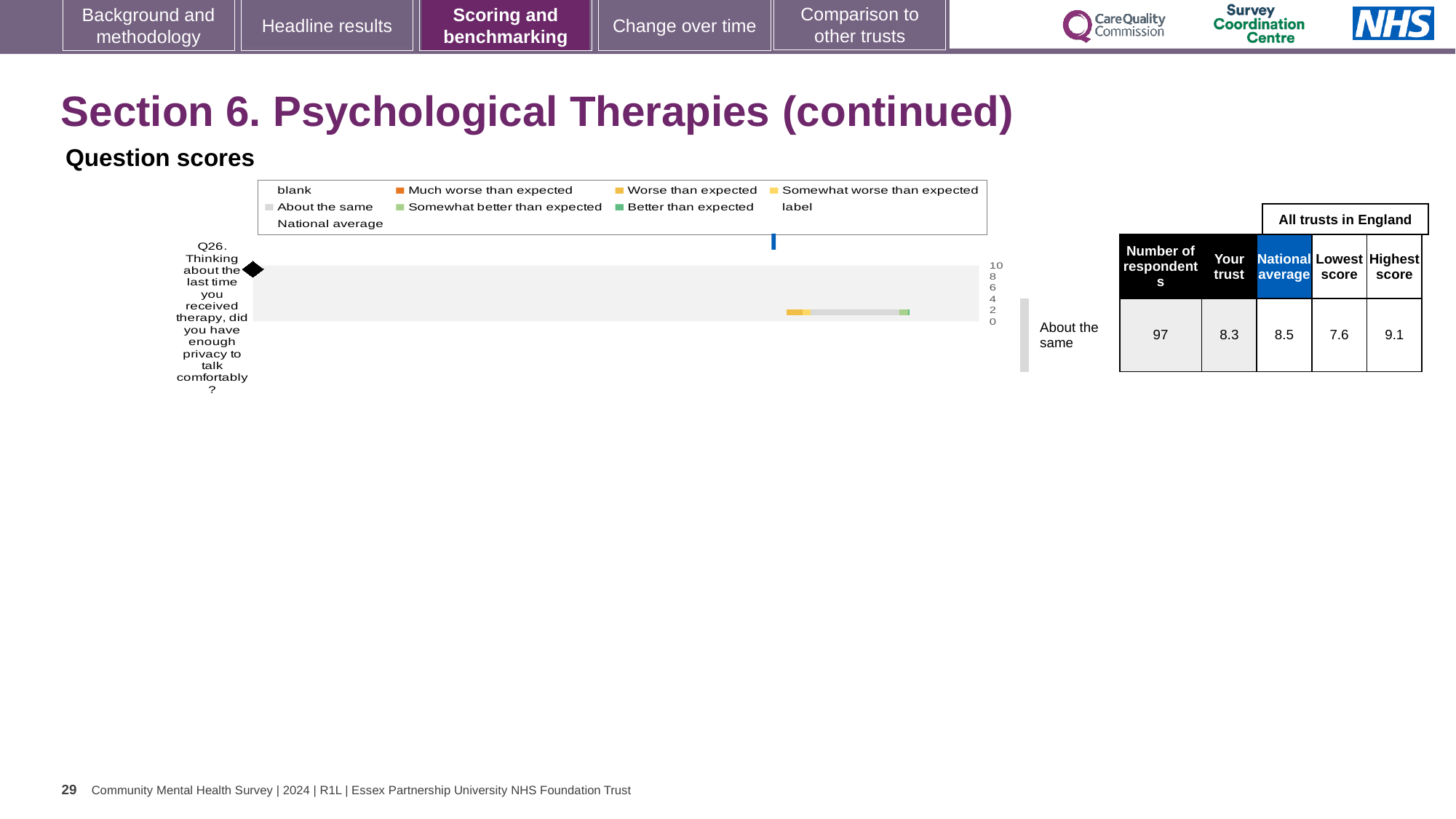
Which is larger for Q26, the 'Your trust' score or the national average? National average What is the difference between the highest score and the lowest score for Q26? 1.5 What is the highest score among all trusts in England for Q26? 9.1 What is the difference between the national average and the 'Your trust' score for Q26? 0.2 How many survey questions are plotted in the Question scores chart? 1 How many respondents answered Q26? 97 What is the 'Your trust' score for Q26 shown in the table next to the chart? 8.3 What benchmarking category is the trust's Q26 score placed in? About the same What kind of chart is shown under 'Question scores'? bar chart What is the lowest score among all trusts in England for Q26? 7.6 What is the national average score for Q26 shown in the table next to the chart? 8.5 Which question number is plotted in the Question scores chart? Q26